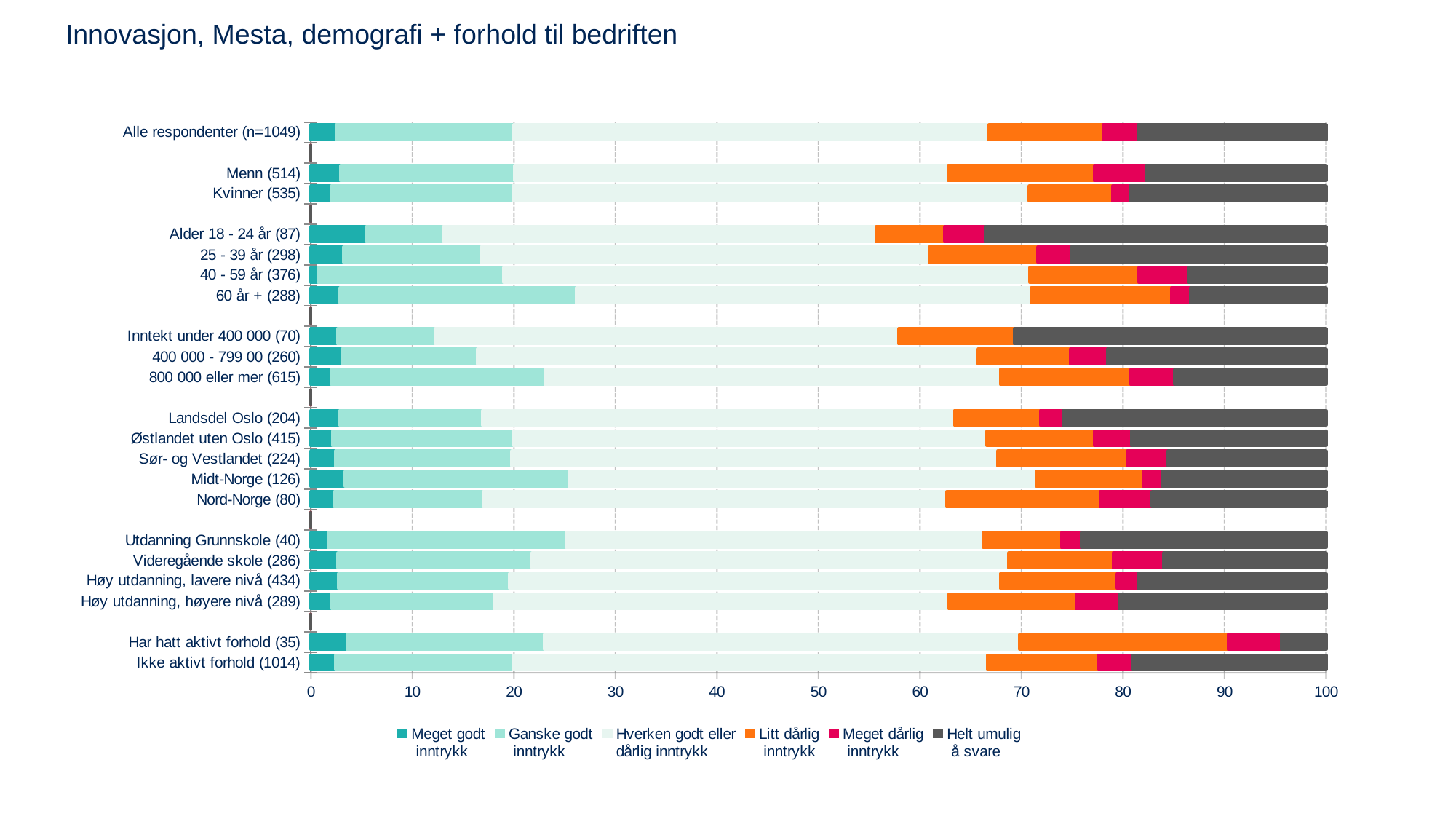
Which group has the larger 'Helt umulig å svare' segment, Alder 18 - 24 år (87) or 60 år + (288)? Alder 18 - 24 år (87) Is the 'Litt dårlig inntrykk' segment for Har hatt aktivt forhold (35) greater or less than 10? greater What is the title of the slide? Innovasjon, Mesta, demografi + forhold til bedriften Which group has the largest 'Litt dårlig inntrykk' segment? Har hatt aktivt forhold (35) Which legend entry is shown in dark grey? Helt umulig å svare Which group has the larger 'Ganske godt inntrykk' segment, 60 år + (288) or Inntekt under 400 000 (70)? 60 år + (288) How many respondent groups (bars) are plotted in the chart? 21 Which group has the largest 'Meget godt inntrykk' segment? Alder 18 - 24 år (87) How many series does the legend list? 6 Is the 'Hverken godt eller dårlig inntrykk' segment for Alle respondenter (n=1049) greater or less than 40? greater What kind of chart is shown on the slide? Stacked bar chart Which group has the smallest 'Helt umulig å svare' segment? Har hatt aktivt forhold (35)